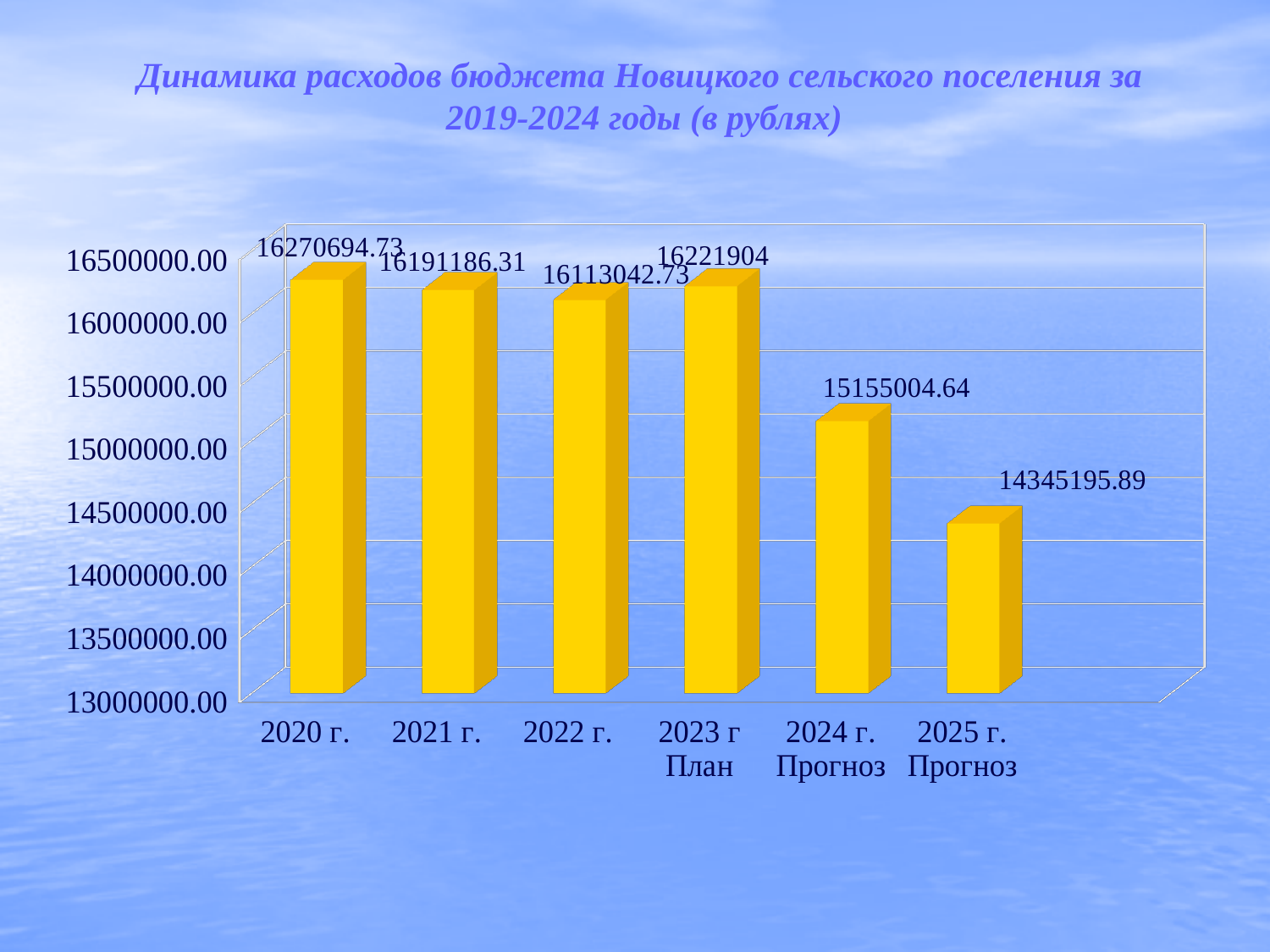
Which category has the highest value? 2020 г. What kind of chart is shown on the slide? bar chart What is the value shown for 2020 г.? 16270694.73 Do the values rise or fall from 2023 г План to 2025 г. Прогноз? fall What is the value shown for 2023 г План? 16221904 What is the difference between the values for 2024 г. Прогноз and 2025 г. Прогноз? 809808.75 What is the difference between the values for 2020 г. and 2021 г.? 79508.42 Is the value for 2024 г. Прогноз greater or less than 15000000.00? greater How many categories are shown on the x axis? 6 Which is larger, the value for 2022 г. or the value for 2023 г План? 2023 г План Which category has the lowest value? 2025 г. Прогноз What is the value shown for 2025 г. Прогноз? 14345195.89